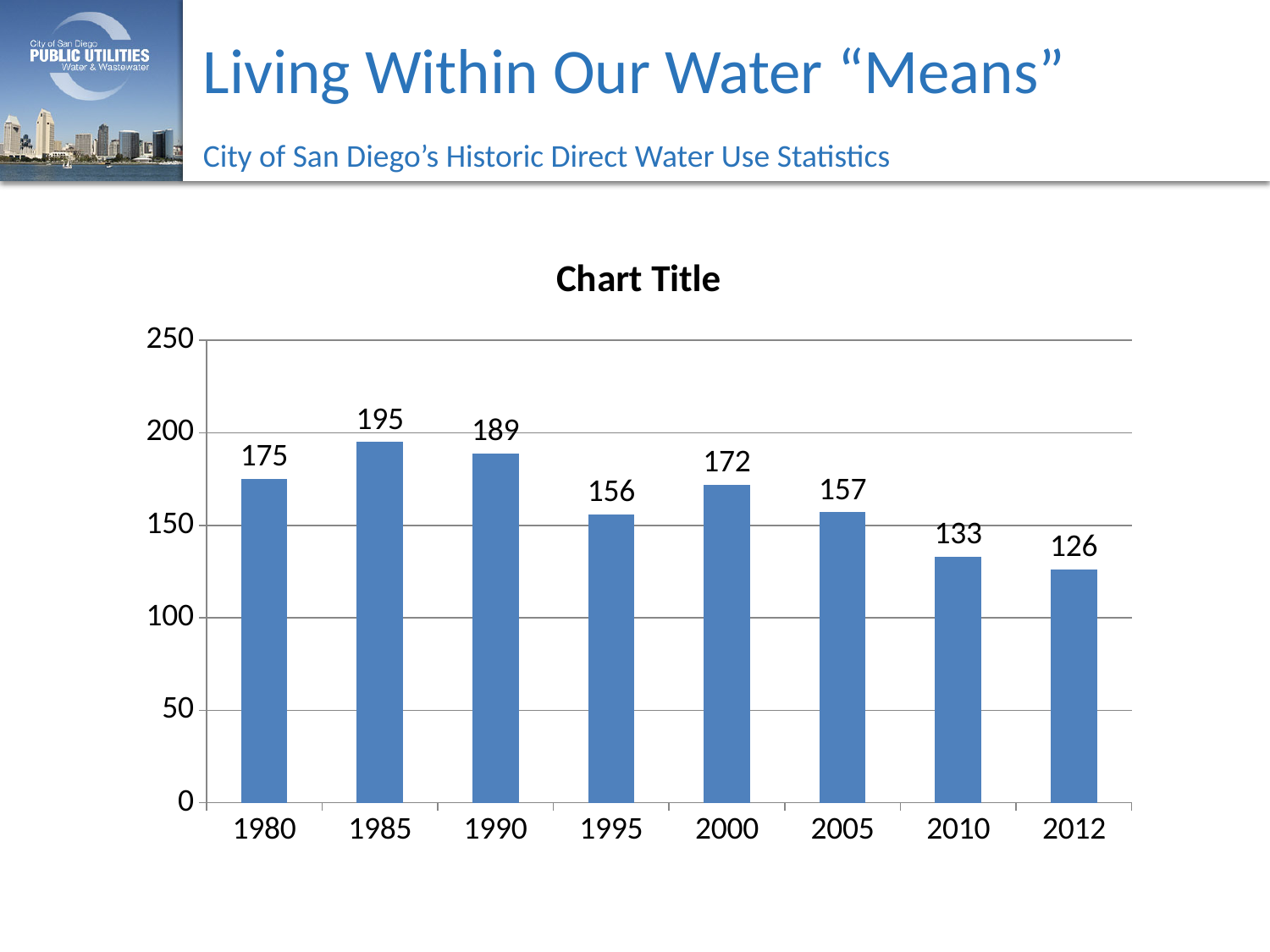
Which is larger, the value for 1980 or the value for 2005? 1980 What is the title printed above the chart? Chart Title What kind of chart is shown on the slide? bar chart Is the value for 2010 greater or less than 150? less What is the value for 2000? 172 What is the difference between the values for 1985 and 2012? 69 What is the value for 2012? 126 What is the difference between the values for 1990 and 1995? 33 Which year has the lowest value? 2012 Which year has the highest value? 1985 How many years are shown on the x axis? 8 What is the value for 1980? 175